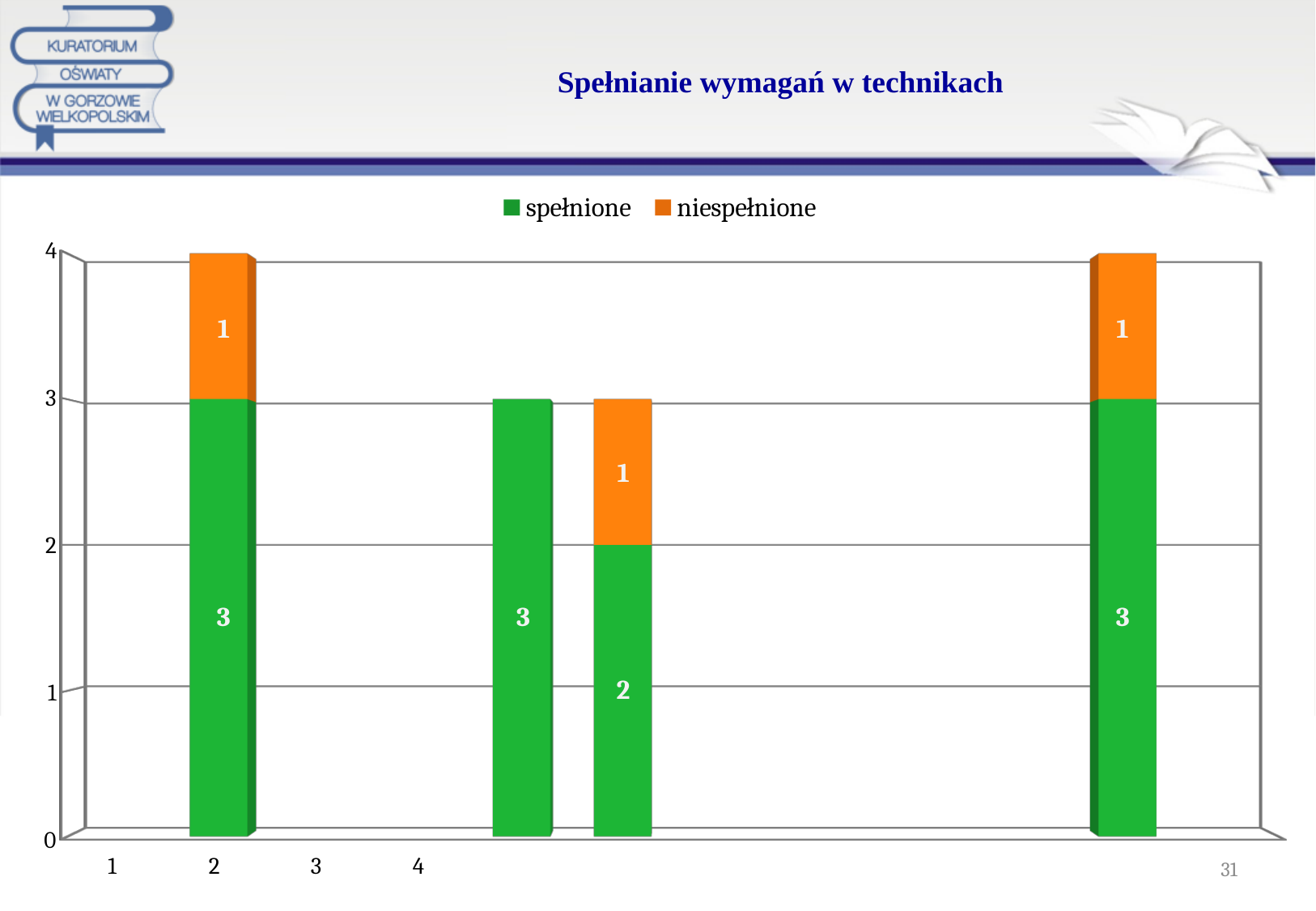
What is the spełnione value of the leftmost bar (above x-axis label 2)? 3 What kind of chart is shown on the slide? bar chart What is the niespełnione value of the leftmost bar (above x-axis label 2)? 1 What are the two series named in the legend? spełnione, niespełnione What is the total height of the third bar from the left? 3 What is the total height of the leftmost bar (spełnione plus niespełnione)? 4 How many stacked bars are plotted in the chart? 4 What is the title of the chart? Spełnianie wymagań w technikach How many series does the legend list? 2 Which bar has the lowest spełnione value? the third bar from the left What is the spełnione value of the third bar from the left? 2 In the leftmost bar, what is the difference between the spełnione and niespełnione values? 2